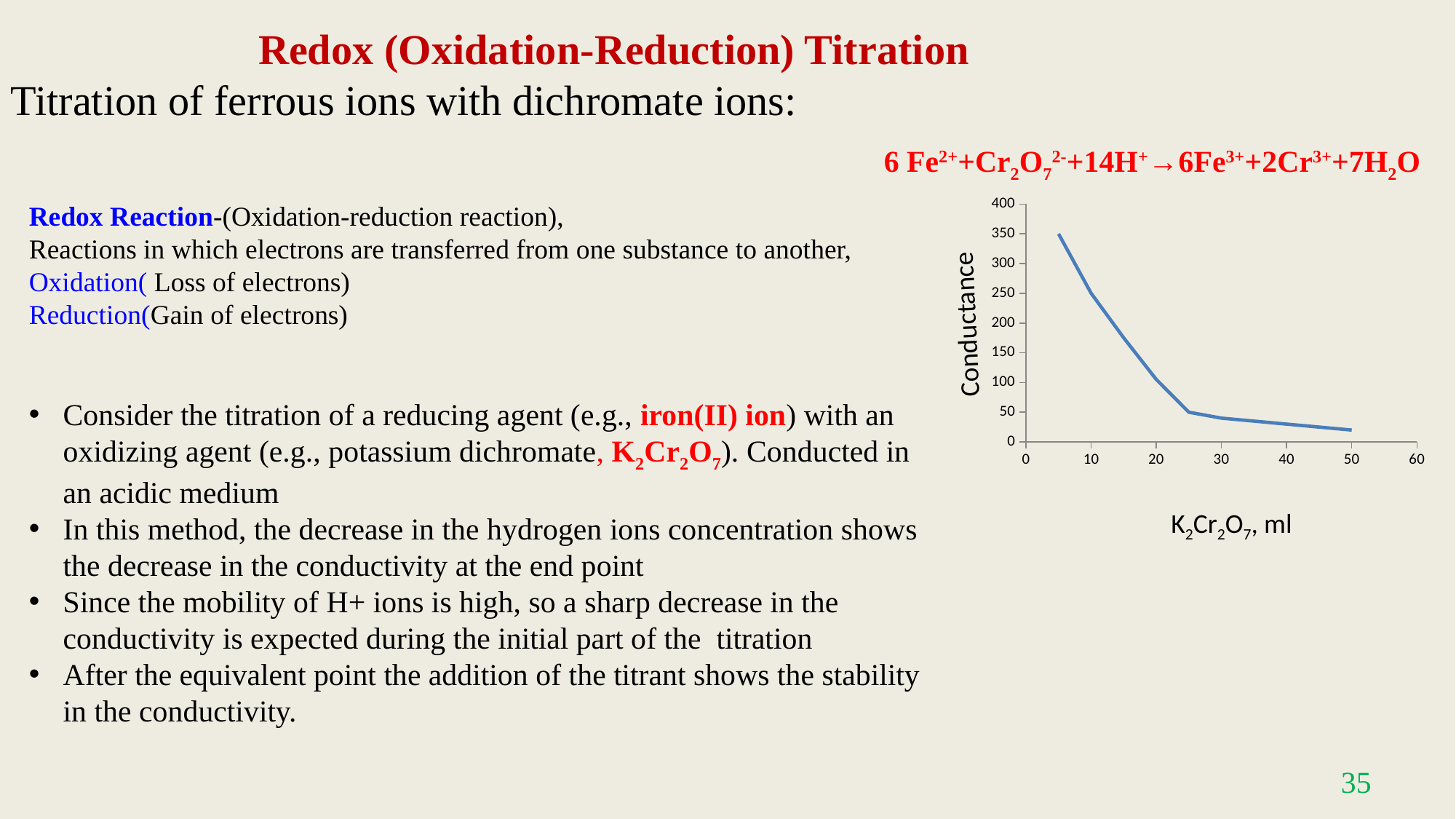
Is the conductance at 10 ml of K2Cr2O7 greater or less than 200? greater Which has the higher conductance: 5 ml or 50 ml of K2Cr2O7? 5 ml Is the conductance at 10 ml of K2Cr2O7 greater or less than 300? less What kind of chart is shown on the slide? line chart Is the conductance at 50 ml of K2Cr2O7 greater or less than 50? less What is the label of the y axis of the chart? Conductance Does the conductance rise or fall as the volume of K2Cr2O7 increases along the x axis? fall What is the label of the x axis of the chart? K2Cr2O7, ml